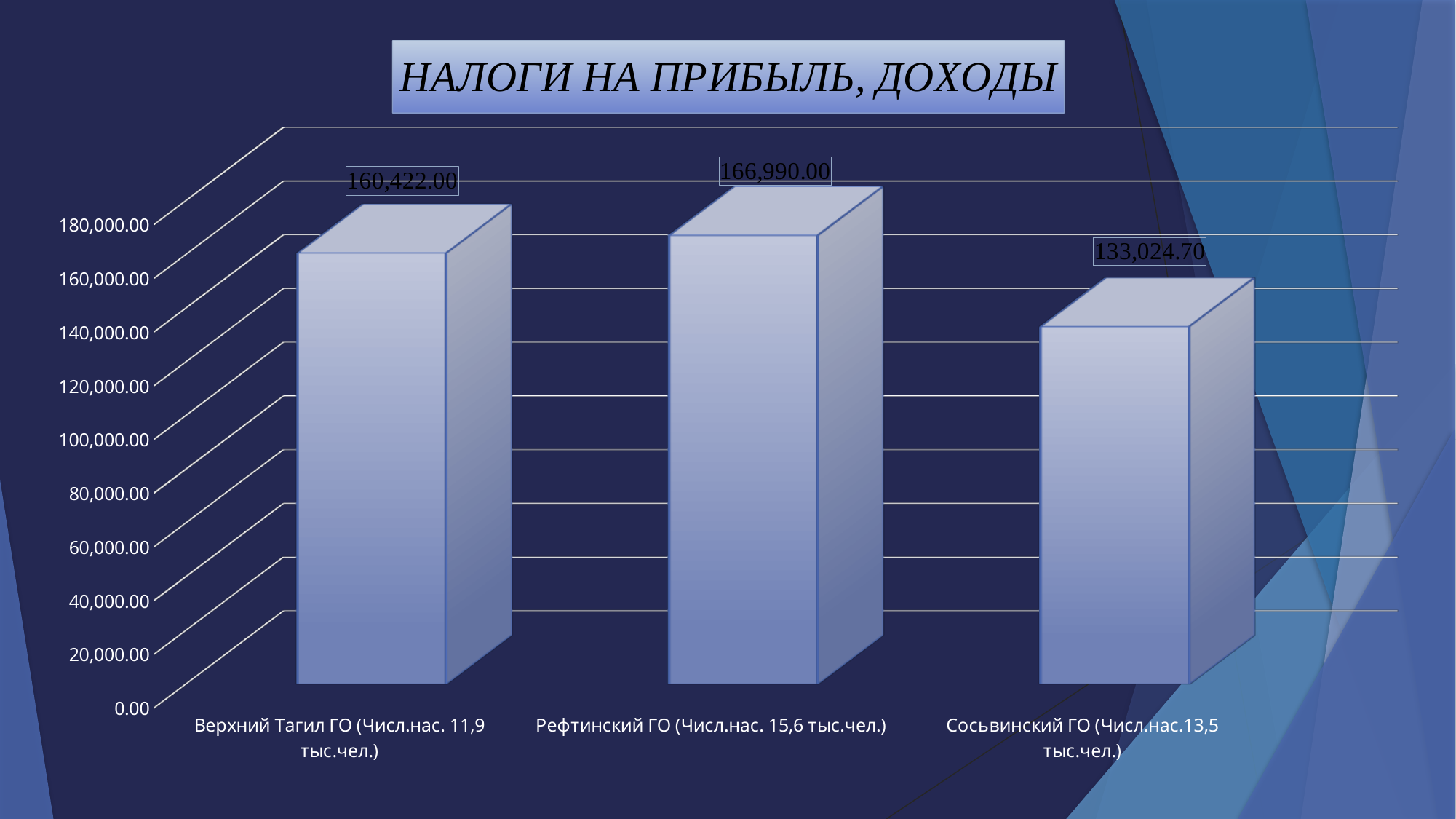
Which category has the highest value? Рефтинский ГО What kind of chart is shown on the slide? bar chart How many categories are shown in the chart? 3 What is the value for Верхний Тагил ГО? 160,422.00 Which category has the lowest value? Сосьвинский ГО What is the value for Сосьвинский ГО? 133,024.70 What is the value for Рефтинский ГО? 166,990.00 What is the difference between the values for Рефтинский ГО and Верхний Тагил ГО? 6,568.00 Is the value for Сосьвинский ГО greater or less than 140,000.00? less What is the difference between the values for Рефтинский ГО and Сосьвинский ГО? 33,965.30 Which is larger, the value for Верхний Тагил ГО or the value for Сосьвинский ГО? Верхний Тагил ГО What is the title of the chart? НАЛОГИ НА ПРИБЫЛЬ, ДОХОДЫ